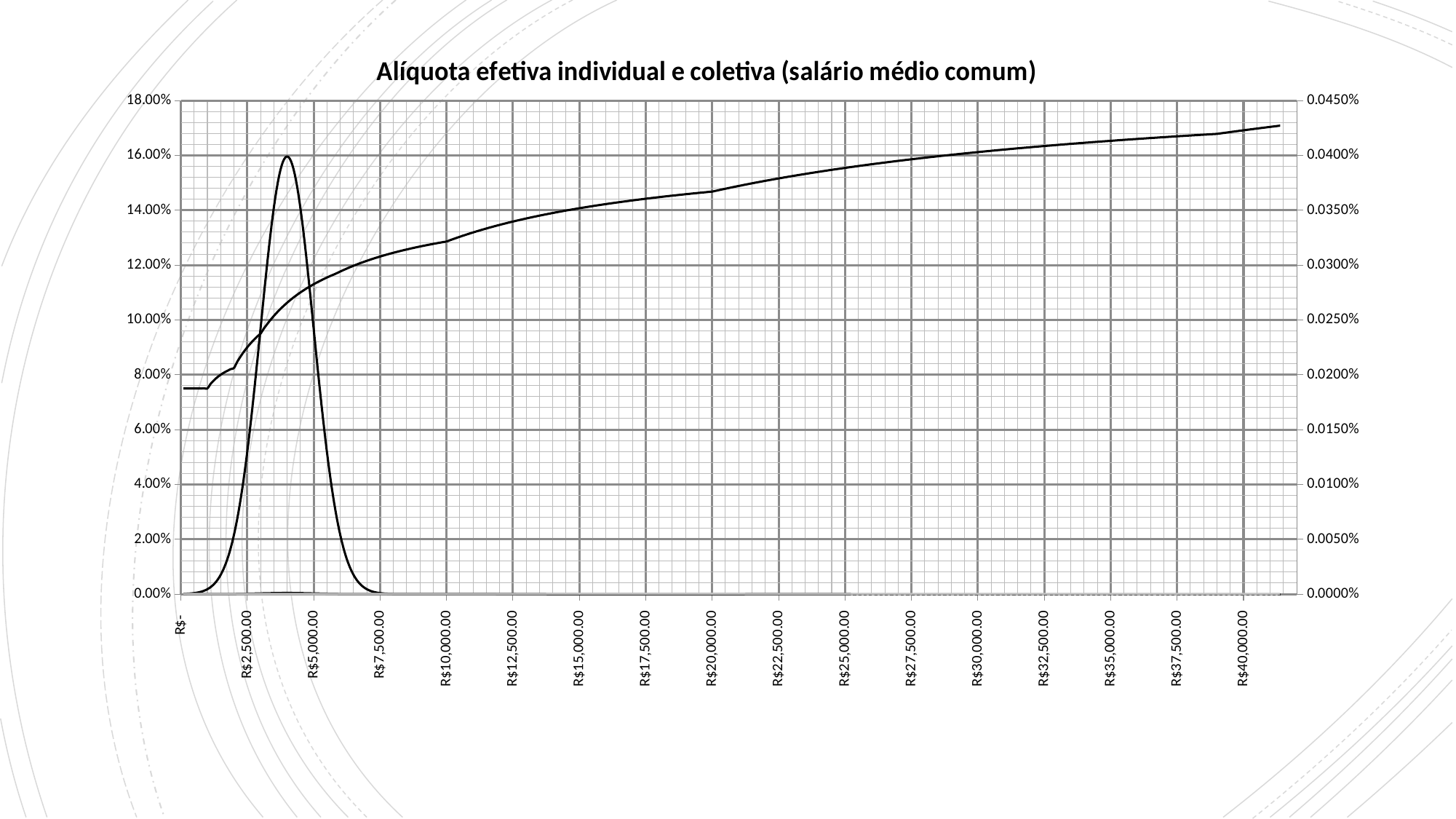
Read against the left axis, is the value of the rising line at R$40,000.00 greater or less than 16.00%? greater What is the highest tick label on the right vertical axis? 0.0450% Read against the left axis, is the value of the rising line at R$- greater or less than 8.00%? less What kind of chart is shown on the slide? line chart What is the title of the chart? Alíquota efetiva individual e coletiva (salário médio comum) What is the spacing between consecutive labelled ticks on the x axis? R$2,500.00 Does the line that starts near 7.5% on the left axis rise or fall as the x axis moves from R$- to R$40,000.00? rise Read against the left axis, is the value of the bell-shaped curve at R$7,500.00 greater or less than 2.00%? less What is the highest tick label on the left vertical axis? 18.00% How many vertical value axes does the chart have? 2 How many labelled tick marks are there on the x axis? 17 Between which two x-axis labels does the bell-shaped curve reach its peak? R$2,500.00 and R$5,000.00